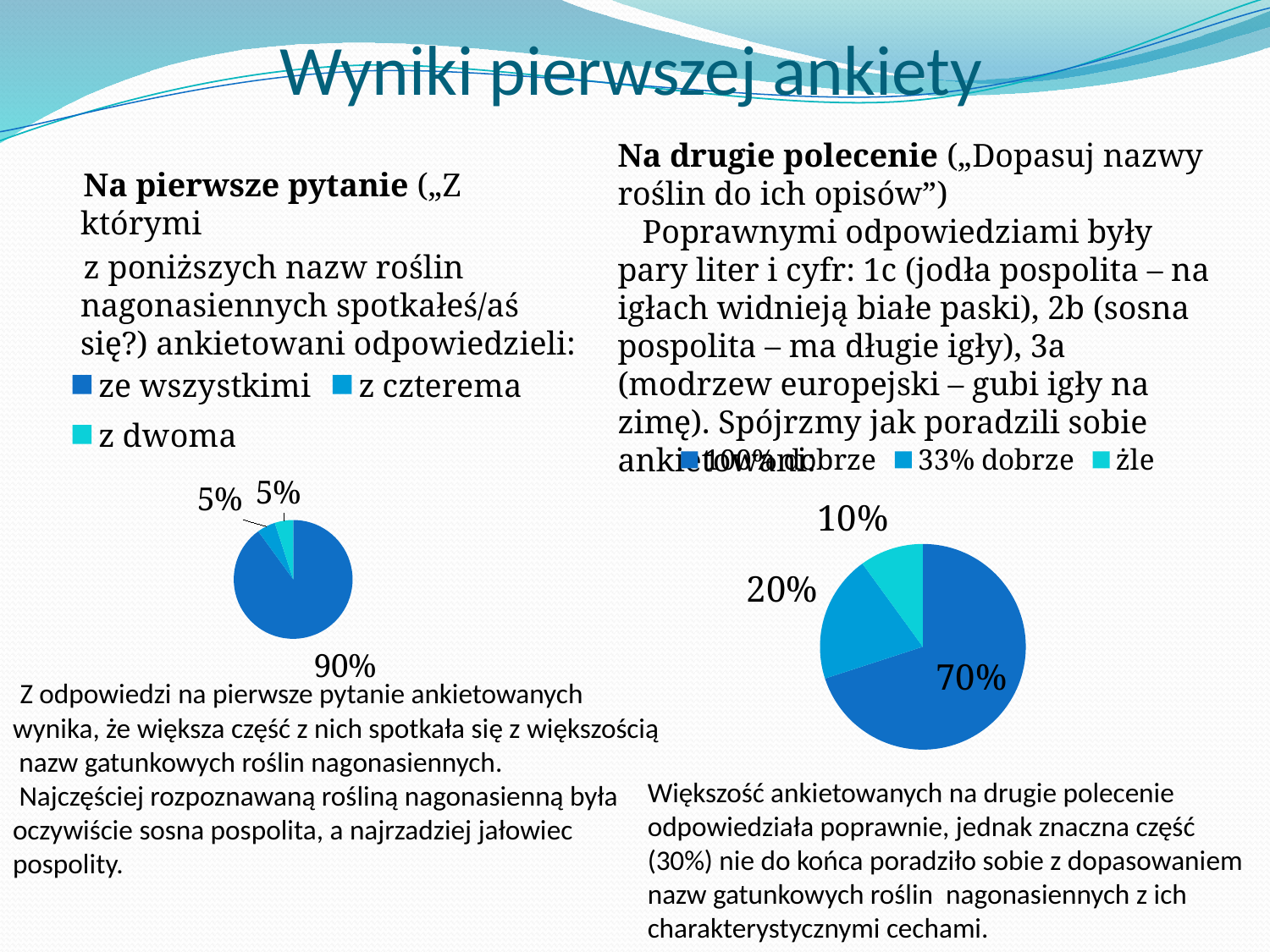
In the right pie chart, what share of respondents is labelled "źle"? 10% In the right pie chart, which is larger: the "33% dobrze" slice or the "źle" slice? 33% dobrze In the right pie chart, what share of respondents is labelled "33% dobrze"? 20% In the right pie chart, what is the difference between the "100% dobrze" share and the "33% dobrze" share? 50% In the left pie chart, which category has the largest slice? ze wszystkimi In the left pie chart, what share of respondents answered "z dwoma"? 5% In the left pie chart, what share of respondents answered "ze wszystkimi"? 90% In the right pie chart, which category has the smallest slice? źle What kind of chart is the chart on the left of the slide? pie chart In the right pie chart, what share of respondents is labelled "100% dobrze"? 70% In the left pie chart, what share of respondents answered "z czterema"? 5% How many entries does the legend of the left pie chart list? 3